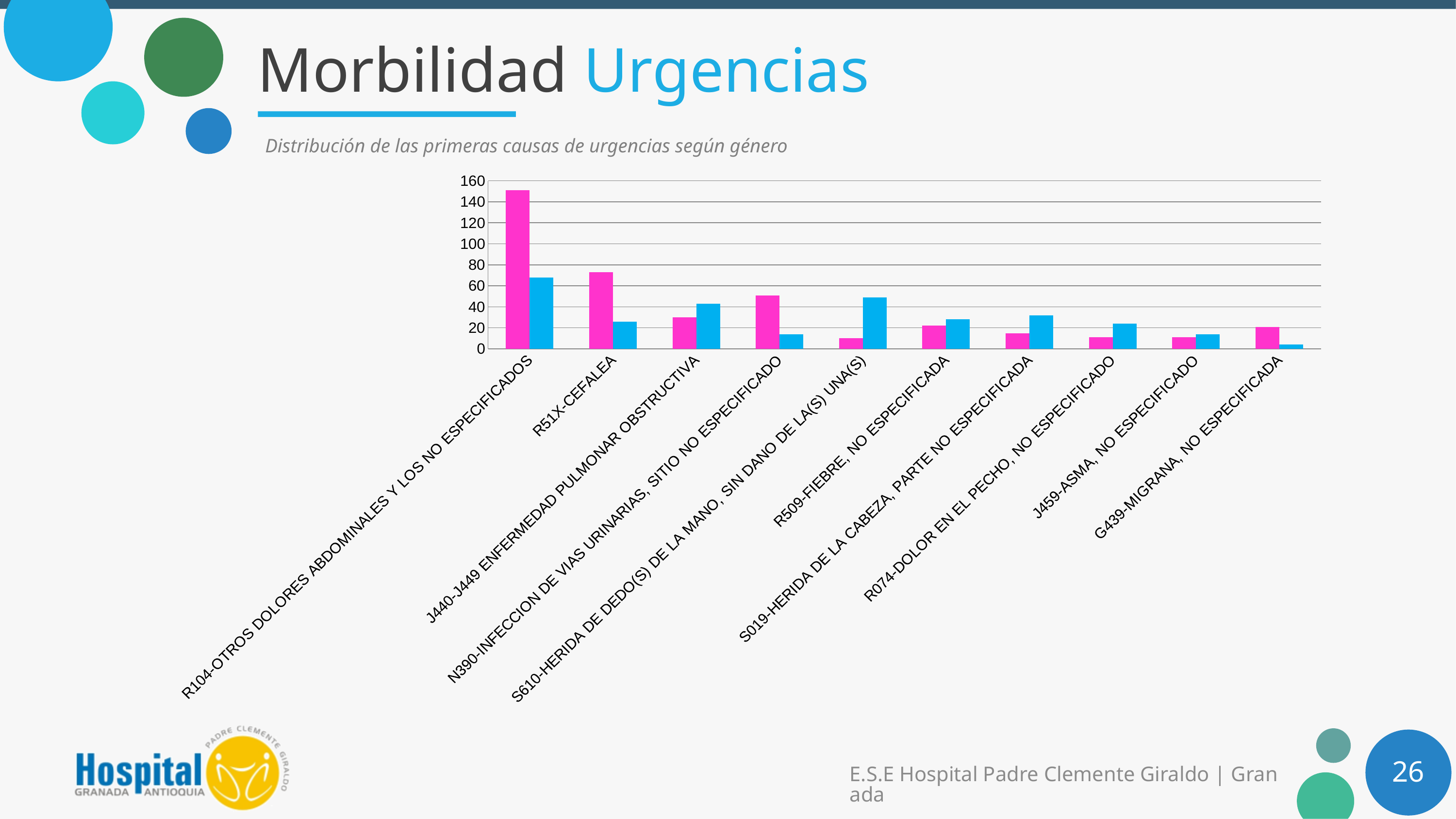
Is the blue bar for R104-OTROS DOLORES ABDOMINALES Y LOS NO ESPECIFICADOS greater or less than 60? greater Which category has the shortest blue bar in the chart? G439-MIGRANA, NO ESPECIFICADA For S610-HERIDA DE DEDO(S) DE LA MANO, SIN DANO DE LA(S) UNA(S), which bar is taller, the pink one or the blue one? blue Is the pink bar for R104-OTROS DOLORES ABDOMINALES Y LOS NO ESPECIFICADOS greater or less than 140? greater Which category has the tallest blue bar in the chart? R104-OTROS DOLORES ABDOMINALES Y LOS NO ESPECIFICADOS What kind of chart is shown on the slide? bar chart How many categories (causes) are shown on the x axis of the chart? 10 Is the blue bar for G439-MIGRANA, NO ESPECIFICADA greater or less than 20? less Which category has the tallest pink bar in the chart? R104-OTROS DOLORES ABDOMINALES Y LOS NO ESPECIFICADOS For R51X-CEFALEA, which bar is taller, the pink one or the blue one? pink What is the subtitle describing the chart on the slide? Distribución de las primeras causas de urgencias según género